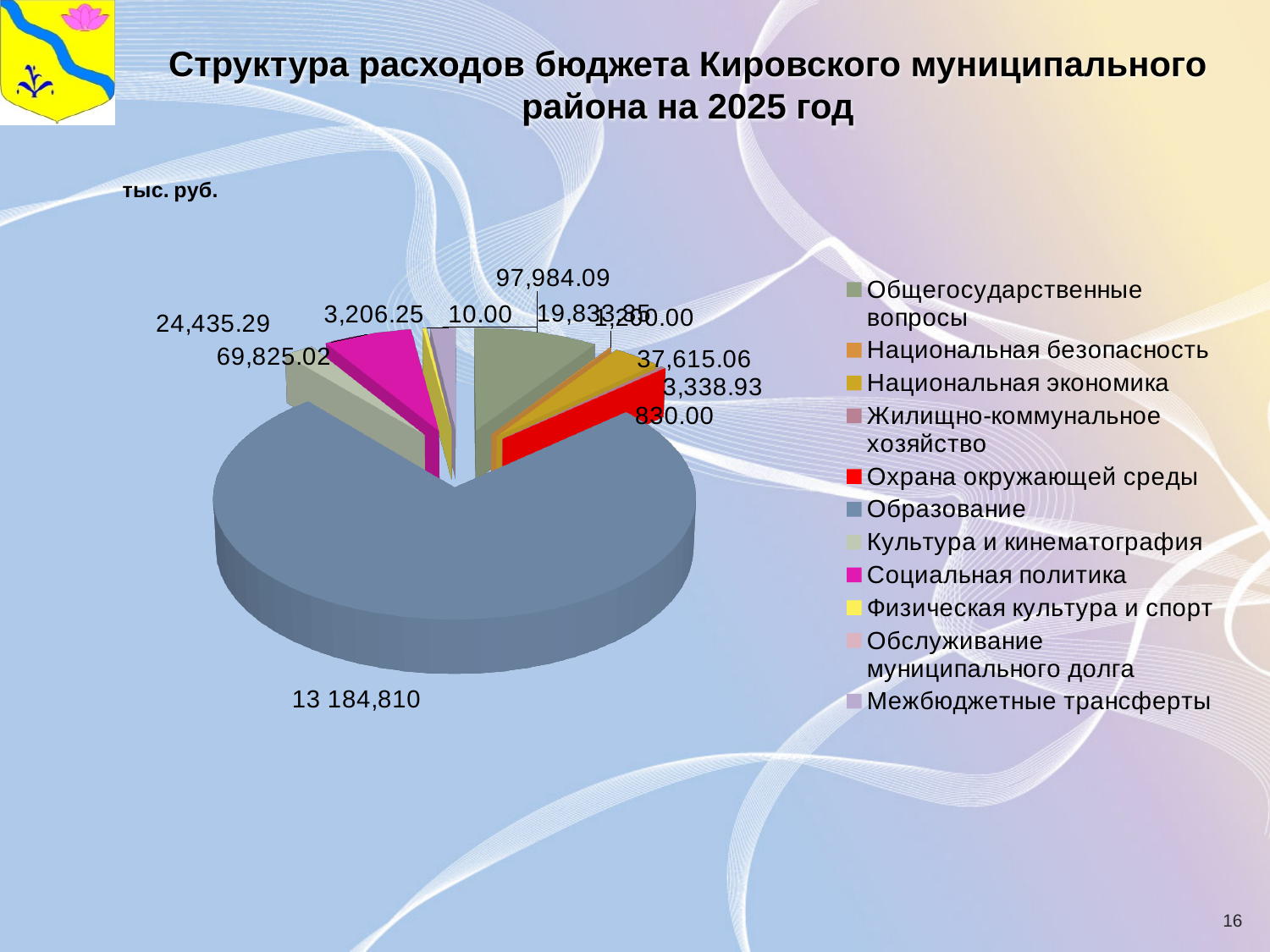
What is the value labelled for Образование? 13 184,810 Which is larger, the value for Культура и кинематография or the value for Социальная политика? Социальная политика What is the value labelled for Социальная политика? 69,825.02 In what units are the values on the chart given? тыс. руб. Which category has the largest slice of the pie chart? Образование How many categories does the legend of the pie chart list? 11 What is the value labelled for Культура и кинематография? 24,435.29 What is the value labelled for Общегосударственные вопросы? 97,984.09 What kind of chart is shown on the slide? Pie chart What is the smallest value labelled on the pie chart? 10.00 What is the title of the chart on the slide? Структура расходов бюджета Кировского муниципального района на 2025 год What is the difference between the values for Культура и кинематография and Социальная политика? 45,389.73